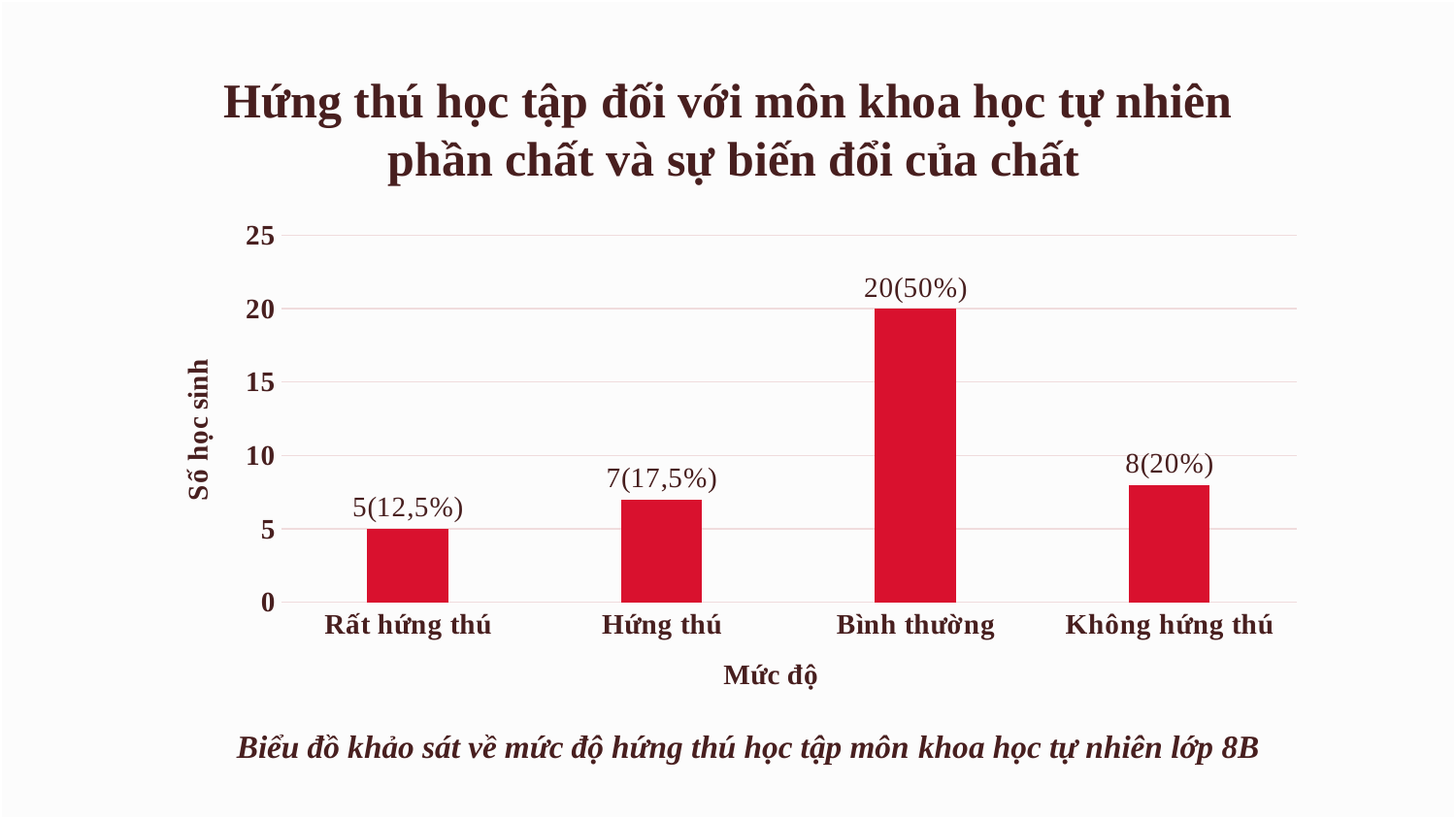
How many categories are shown on the x axis? 4 What is the value for Bình thường? 20(50%) What is the label of the y axis? Số học sinh Which category has the highest number of students? Bình thường What is the value for Không hứng thú? 8(20%) What is the difference in number of students between Bình thường and Không hứng thú? 12 What kind of chart is this? bar chart Which category has the lowest number of students? Rất hứng thú Is the value for Bình thường greater or less than 15? greater What is the value for Hứng thú? 7(17,5%) What is the value for Rất hứng thú? 5(12,5%) Which is larger, the value for Hứng thú or the value for Không hứng thú? Không hứng thú